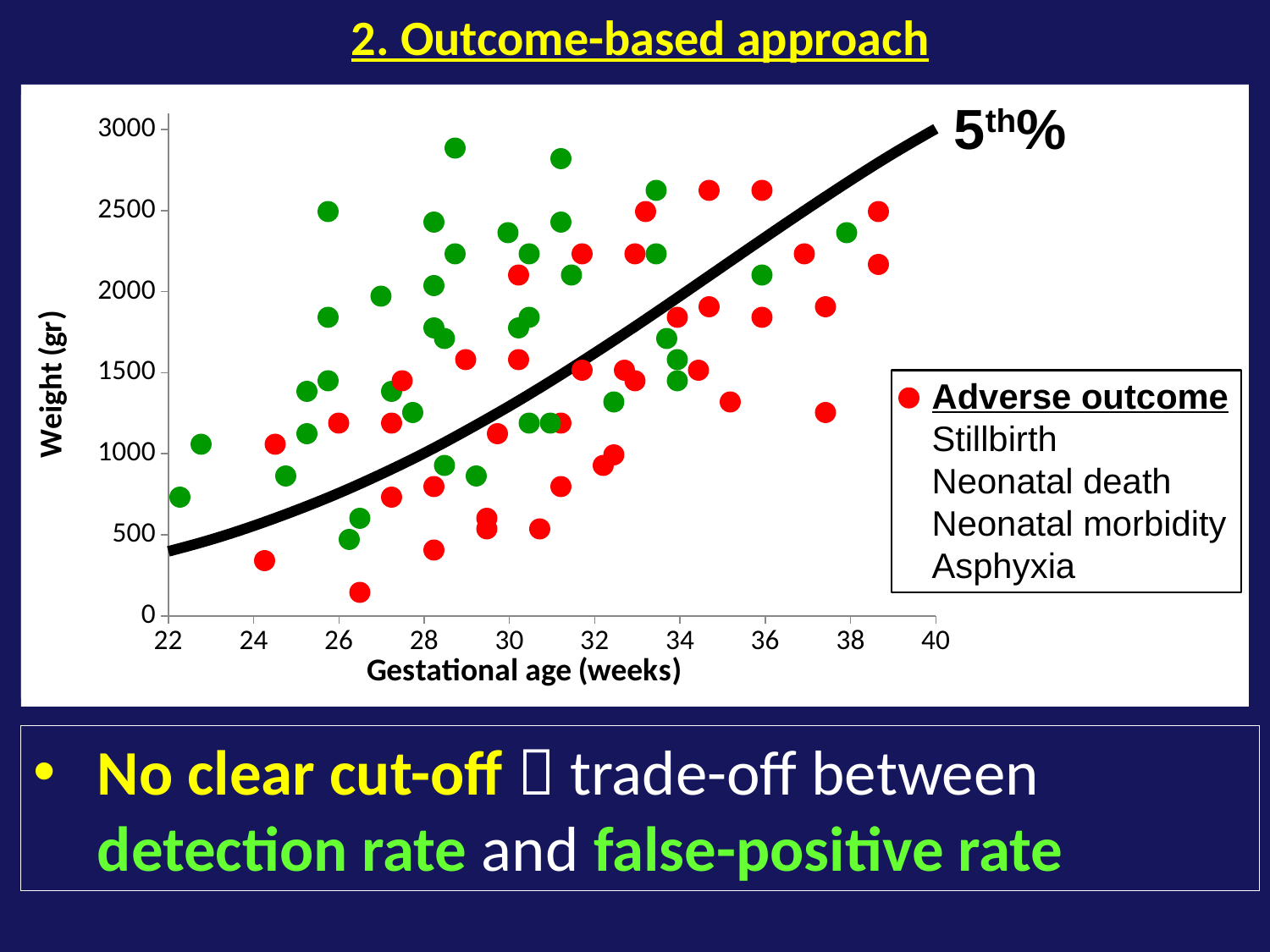
Is the value of the 5th% curve at 40 weeks greater or less than 2500? greater Is the value of the 5th% curve at 30 weeks greater or less than 1000? greater Is the value of the 5th% curve at 22 weeks greater or less than 500? less Does the 5th% curve rise or fall as gestational age increases? rises What colour are the markers for Adverse outcome in the legend? red What kind of chart is shown on the slide? scatter chart What is the title of the vertical axis? Weight (gr)